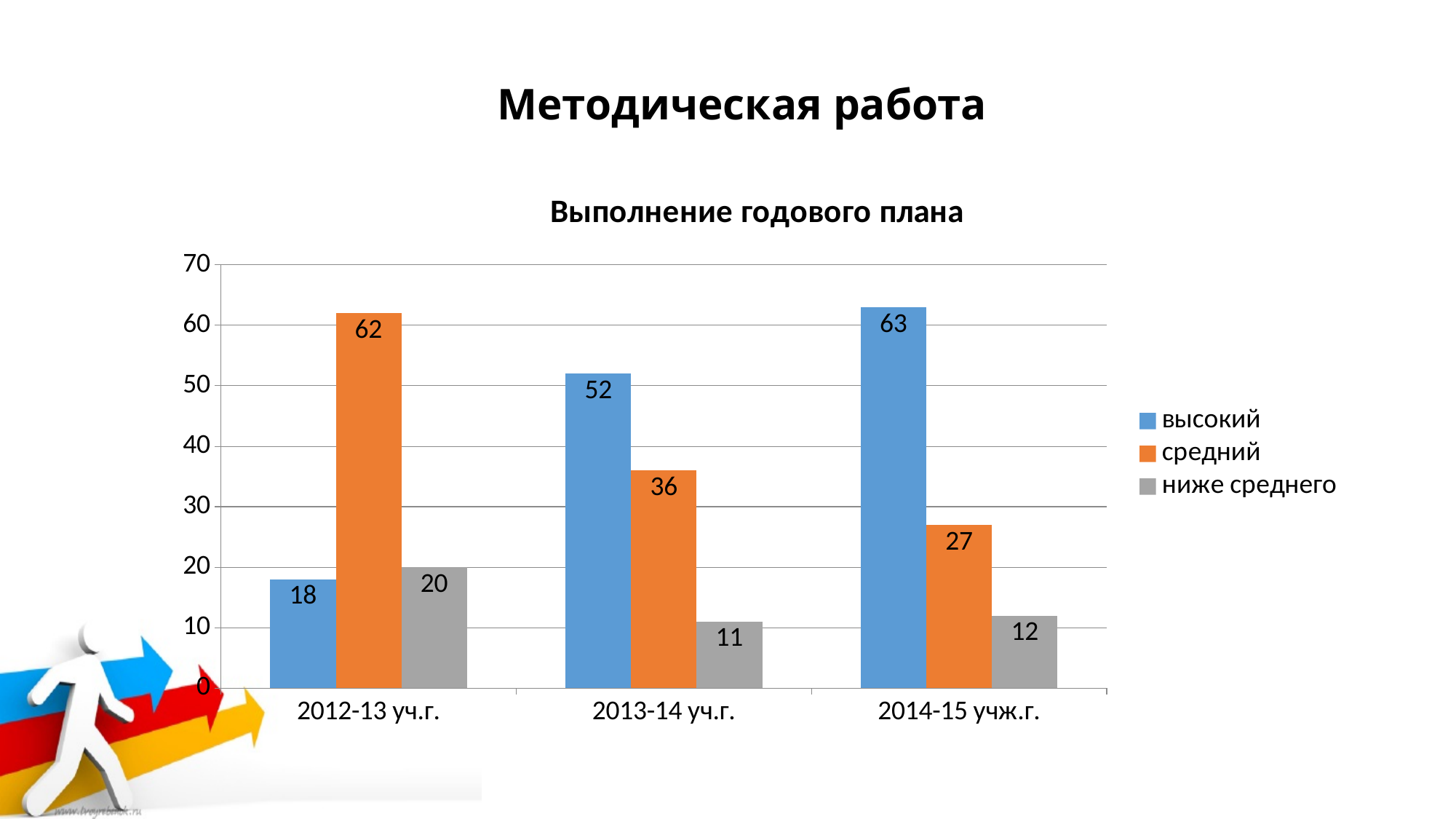
What is the difference between the средний values for 2012-13 уч.г. and 2014-15 учж.г.? 35 What is the value for ниже среднего in 2014-15 учж.г.? 12 What is the title of the chart? Выполнение годового плана Does the средний series rise or fall from 2012-13 уч.г. to 2014-15 учж.г.? fall How many year categories are shown on the x axis? 3 In which year is the высокий series highest? 2014-15 учж.г. What is the value for высокий in 2012-13 уч.г.? 18 In which year is the ниже среднего series lowest? 2013-14 уч.г. Which is larger in 2013-14 уч.г.: высокий or средний? высокий How many series does the legend list? 3 What is the value for средний in 2013-14 уч.г.? 36 What kind of chart is shown? bar chart